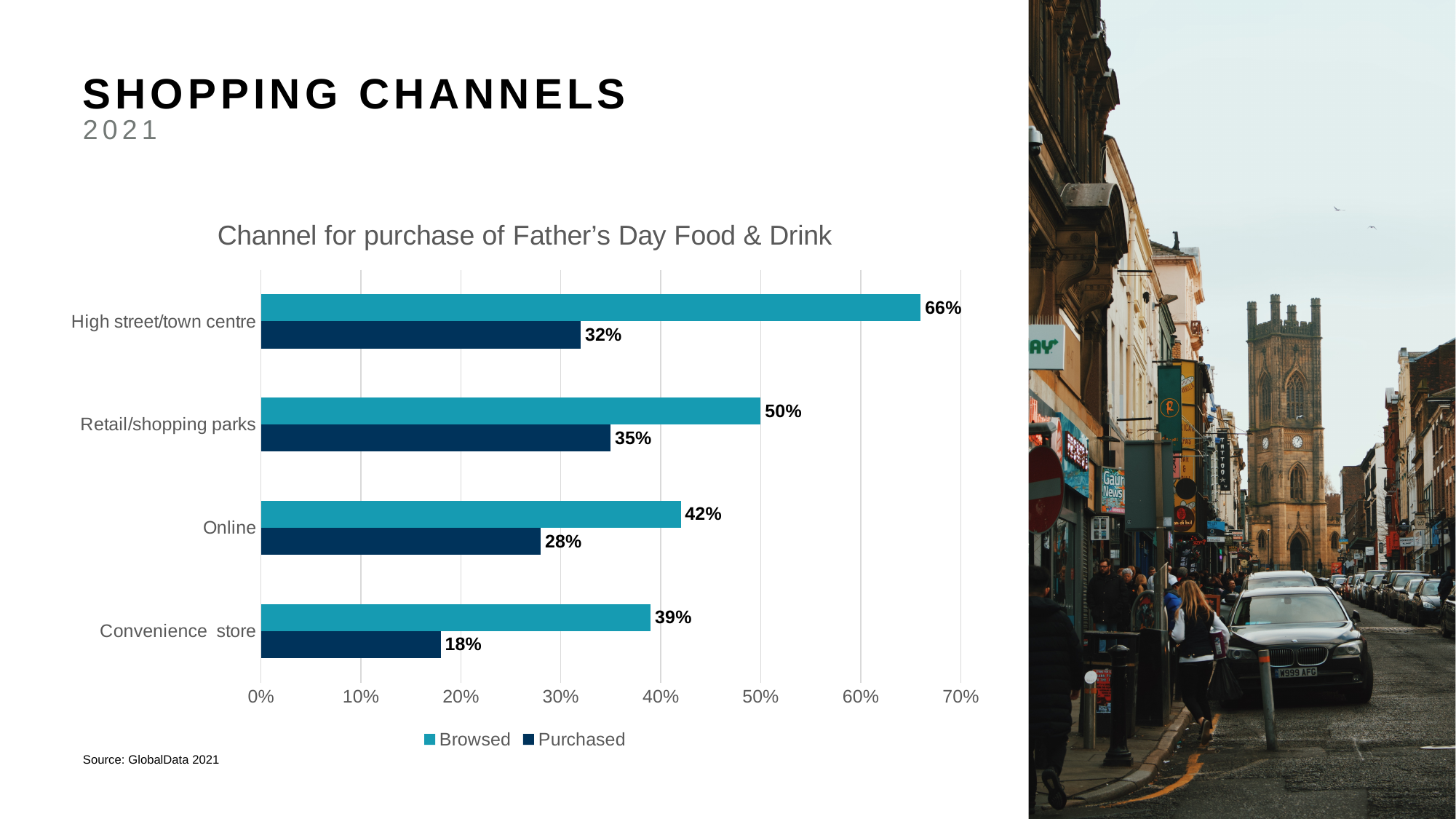
Which channel has the highest Browsed value? High street/town centre What type of chart is shown on the slide? Bar chart How many series does the legend list? 2 What percentage browsed for Father's Day Food & Drink on the High street/town centre? 66% How many shopping channels are shown in the chart? 4 What is the title of the chart? Channel for purchase of Father's Day Food & Drink What is the difference between the Browsed and Purchased values for Online? 14% Is the Browsed value for Convenience store greater or less than 40%? less What is the Purchased value for Retail/shopping parks? 35% Which is larger: the Purchased value for High street/town centre or the Purchased value for Retail/shopping parks? Retail/shopping parks What percentage purchased Father's Day Food & Drink at a Convenience store? 18% Which channel has the lowest Purchased value? Convenience store